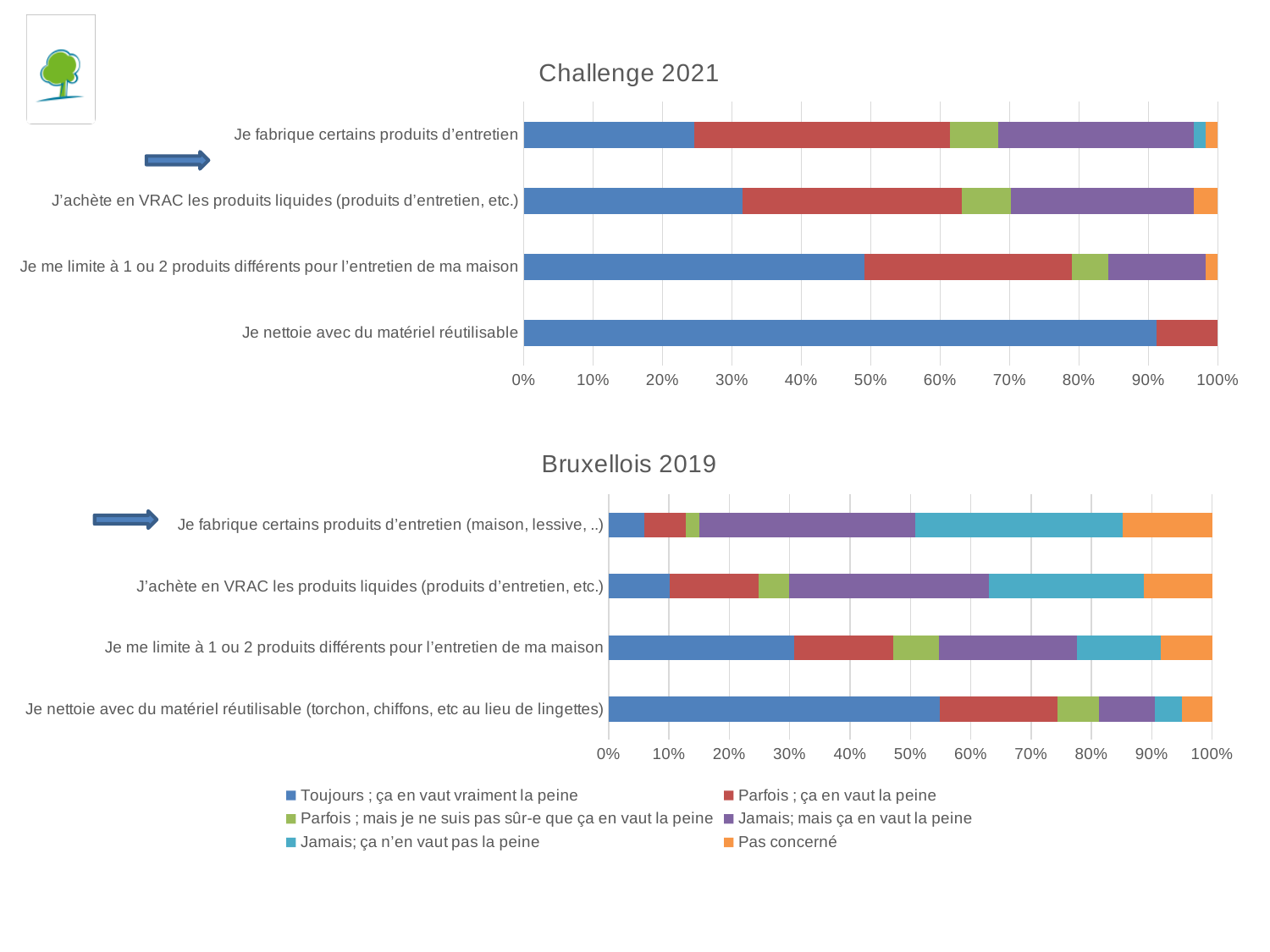
In the 'Bruxellois 2019' chart, is the 'Toujours ; ça en vaut vraiment la peine' share for 'Je me limite à 1 ou 2 produits différents pour l'entretien de ma maison' greater or less than 40%? less In the 'Challenge 2021' chart, is the 'Toujours ; ça en vaut vraiment la peine' share for 'Je nettoie avec du matériel réutilisable' greater or less than 80%? greater What is the title of the lower chart on the slide? Bruxellois 2019 In the 'Bruxellois 2019' chart, which has the larger 'Toujours ; ça en vaut vraiment la peine' share: 'Je me limite à 1 ou 2 produits différents pour l'entretien de ma maison' or 'J'achète en VRAC les produits liquides (produits d'entretien, etc.)'? Je me limite à 1 ou 2 produits différents pour l'entretien de ma maison In the 'Challenge 2021' chart, which category has the largest 'Toujours ; ça en vaut vraiment la peine' share? Je nettoie avec du matériel réutilisable What kind of chart is the 'Challenge 2021' chart? Stacked bar chart How many series does the legend at the bottom of the slide list? 6 In the 'Bruxellois 2019' chart, is the 'Toujours ; ça en vaut vraiment la peine' share for 'Je fabrique certains produits d'entretien (maison, lessive, ..)' greater or less than 10%? less How many categories (statements) does the 'Bruxellois 2019' chart show? 4 In the 'Bruxellois 2019' chart, which category has the largest 'Toujours ; ça en vaut vraiment la peine' share? Je nettoie avec du matériel réutilisable (torchon, chiffons, etc au lieu de lingettes) In the 'Challenge 2021' chart, which category has the smallest 'Toujours ; ça en vaut vraiment la peine' share? Je fabrique certains produits d'entretien